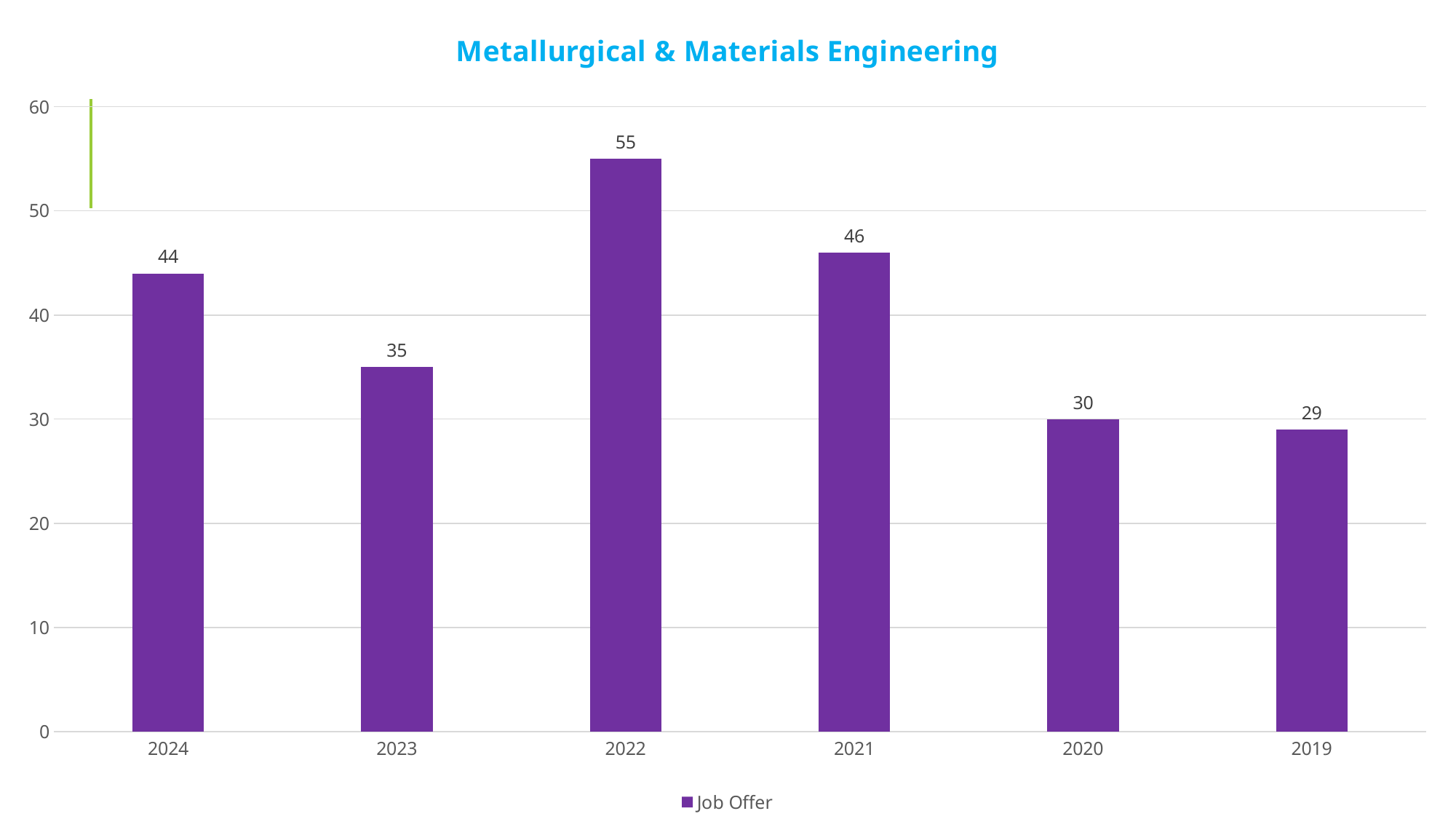
Which year has a larger Job Offer value, 2023 or 2021? 2021 What is the difference between the Job Offer values for 2022 and 2021? 9 How many years are shown on the x axis? 6 Which year has the lowest Job Offer value? 2019 What is the title of the chart? Metallurgical & Materials Engineering Is the Job Offer value for 2020 greater or less than 40? less Which year has the highest Job Offer value? 2022 What kind of chart is shown? bar chart What is the Job Offer value for 2022? 55 What is the Job Offer value for 2024? 44 What is the Job Offer value for 2019? 29 How many series does the legend list? 1